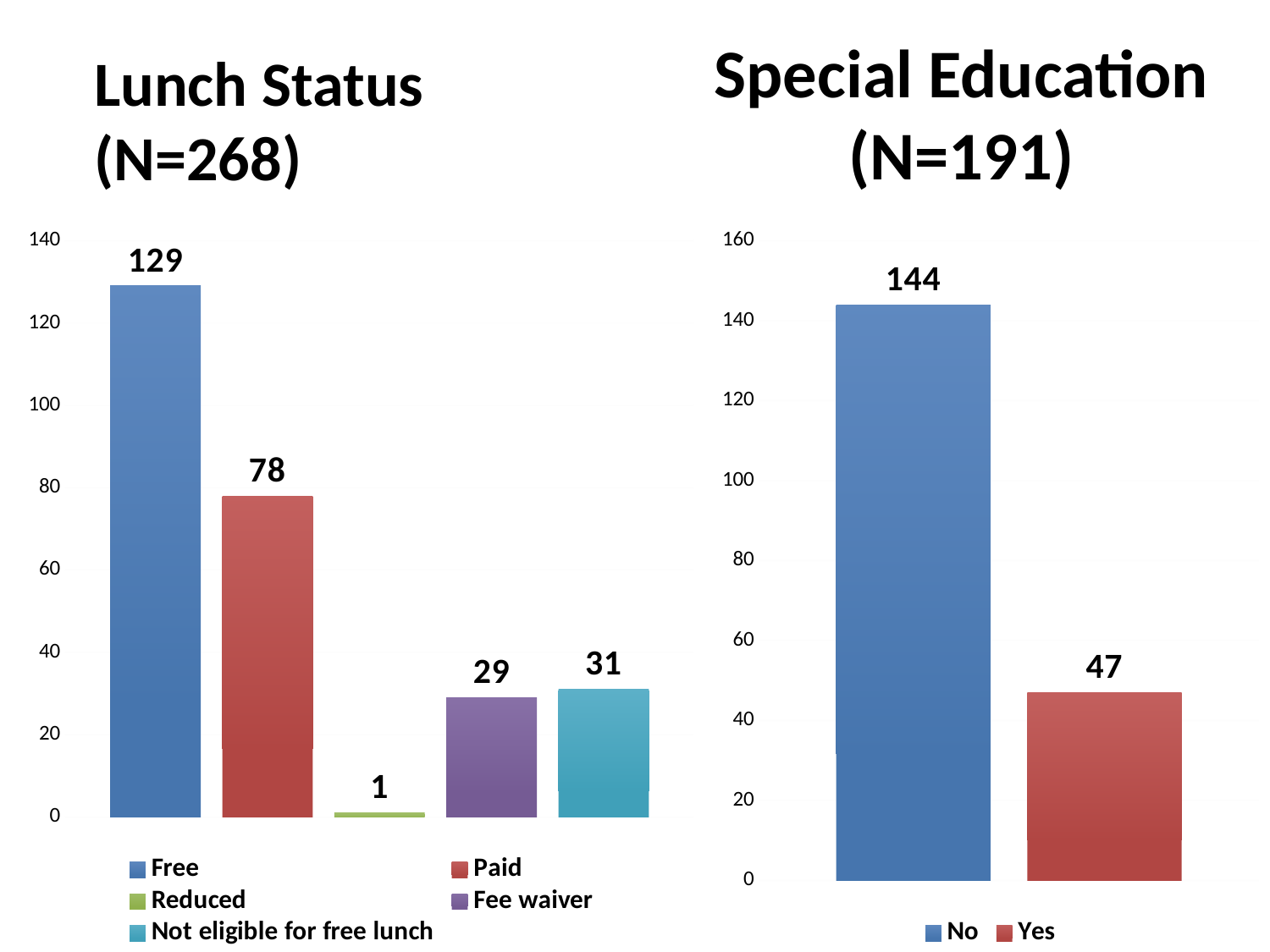
In the Lunch Status chart, what is the value for Not eligible for free lunch? 31 What kind of chart is the Special Education chart? Bar chart In the Special Education chart, what is the value for No? 144 In the Lunch Status chart, what is the difference between Free and Paid? 51 In the Lunch Status chart, which category has the highest value? Free In the Lunch Status chart, how many categories does the legend list? 5 In the Lunch Status chart, what is the value for Paid? 78 In the Lunch Status chart, what is the value for Free? 129 In the Special Education chart, which is larger, No or Yes? No In the Special Education chart, what is the difference between No and Yes? 97 In the Lunch Status chart, which category has the lowest value? Reduced In the Special Education chart, what is the value for Yes? 47